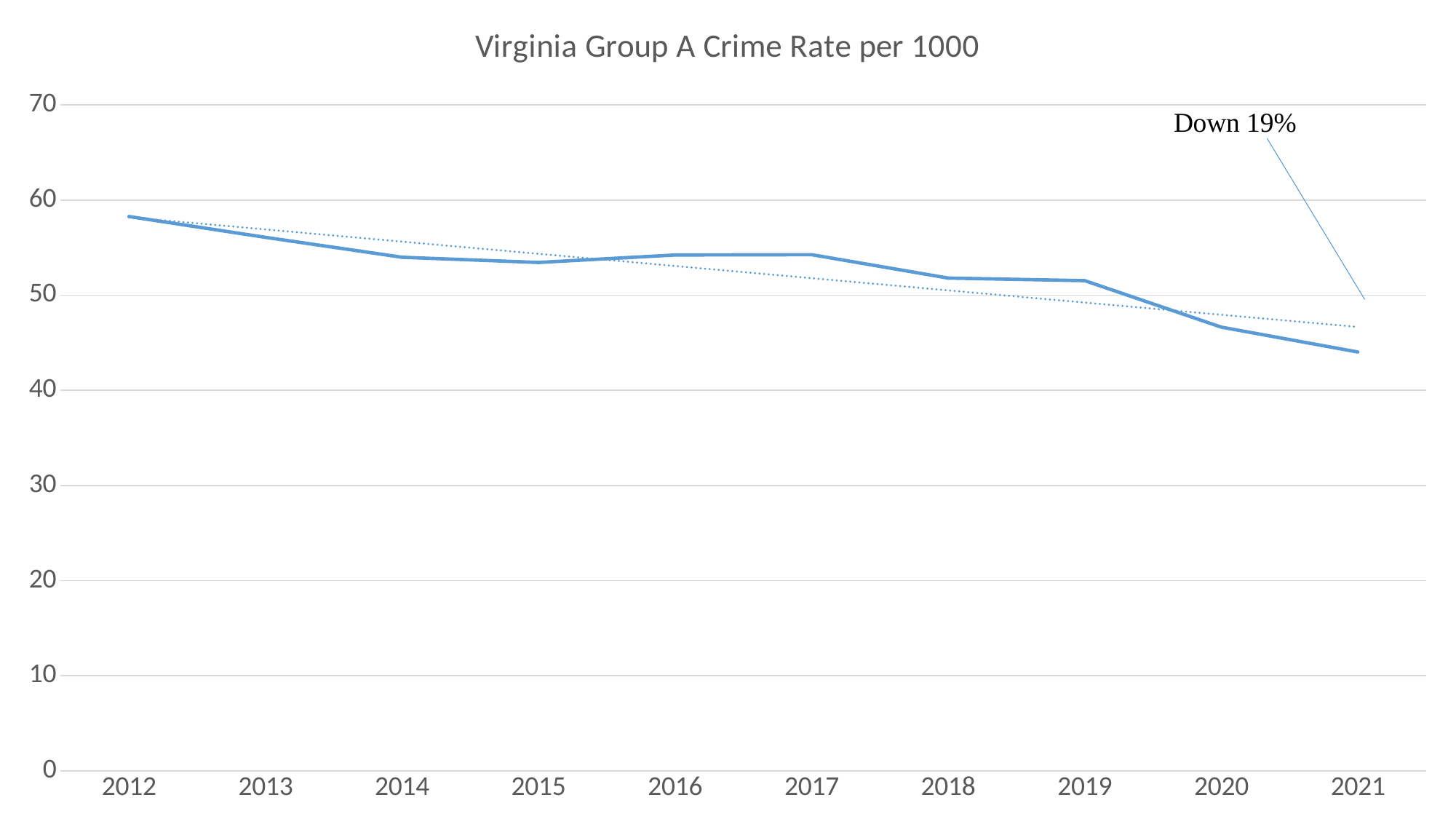
Which year has the lowest crime rate? 2021 Which year has the highest crime rate? 2012 Which year has the higher crime rate, 2014 or 2018? 2014 Is the value for 2020 greater or less than 50? less What kind of chart is shown on the slide? line chart What is the title of the chart? Virginia Group A Crime Rate per 1000 Is the value for 2017 greater or less than 60? less Is the value for 2012 greater or less than 50? greater What percentage change does the annotation on the chart state? Down 19% Do the values generally rise or fall from 2012 to 2021? fall How many years are plotted along the x axis? 10